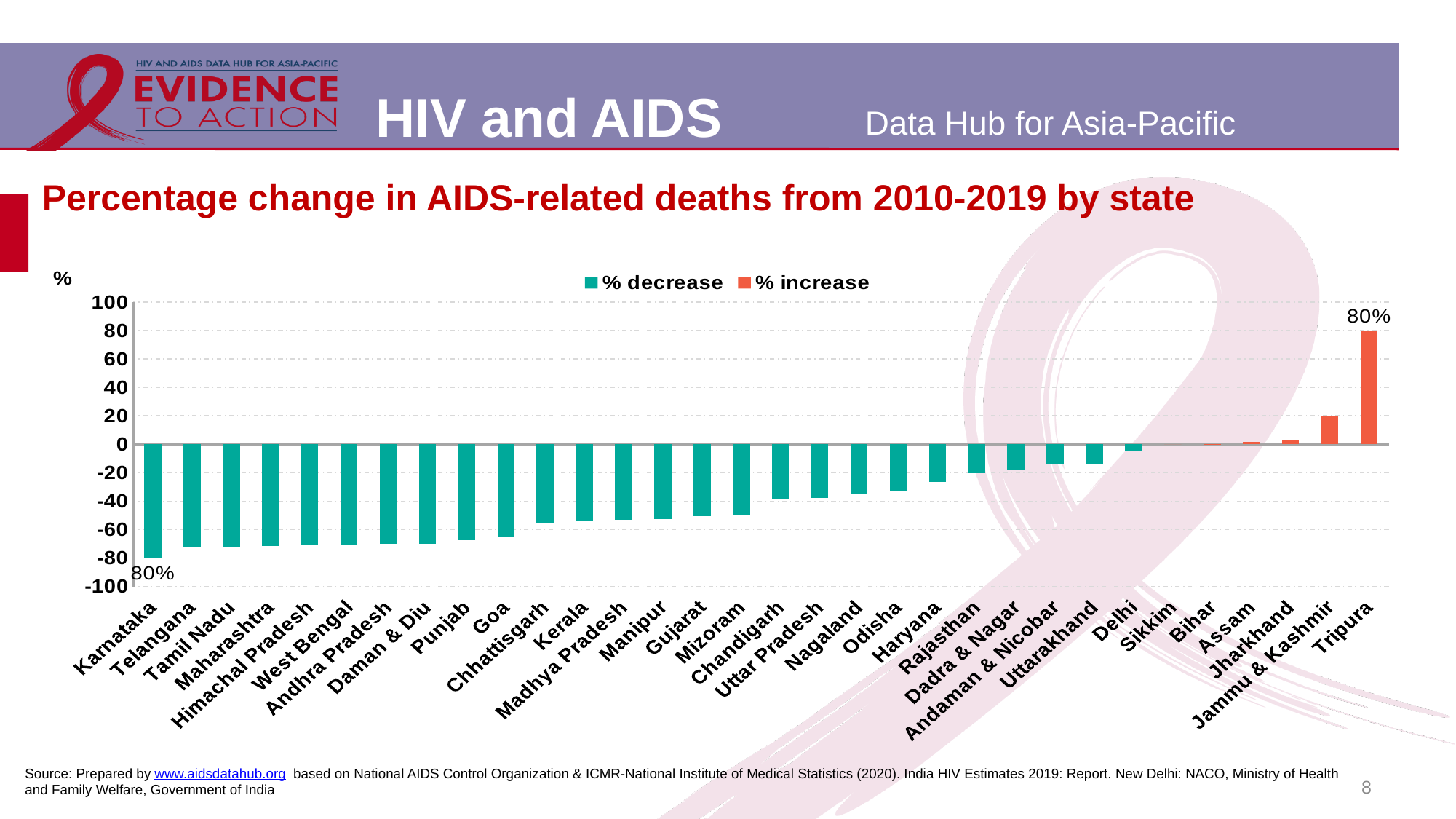
Which has the larger value, Tripura or Jammu & Kashmir? Tripura Is the value for Telangana greater or less than -60? less Do the values rise or fall moving from left to right along the x axis? Rise How many series does the legend list? 2 Which state has the lowest percentage change (largest decrease)? Karnataka Which state has the highest percentage change (largest increase)? Tripura What is the data label shown for Tripura? 80% What is the data label shown for Karnataka? 80% How many states/territories are shown on the x axis? 32 What type of chart is shown on the slide? Bar chart What are the two series named in the legend? % decrease and % increase Is the value for Nagaland greater or less than -40? greater